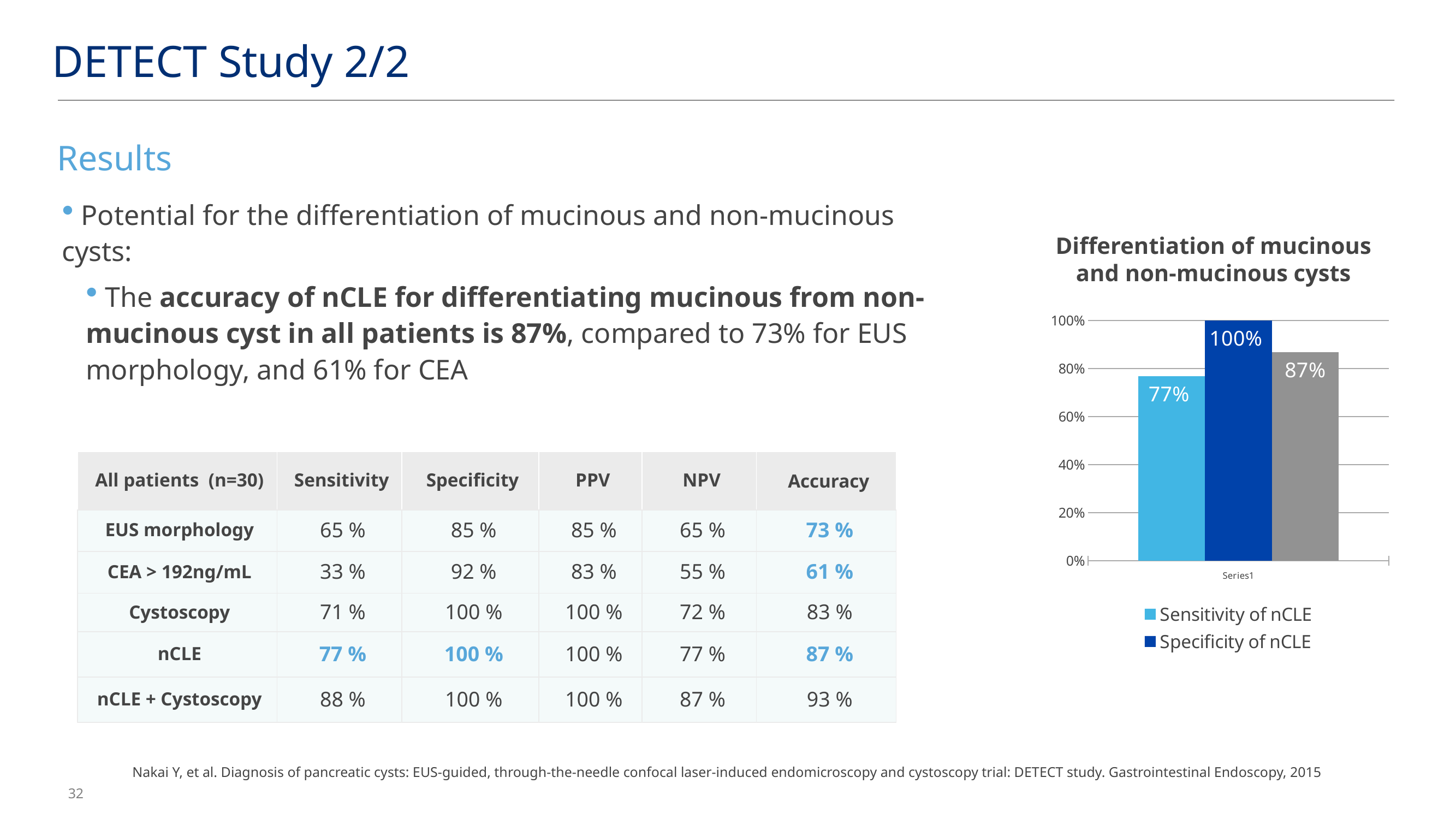
Which legend series has the highest bar in the chart? Specificity of nCLE Is the value for Sensitivity of nCLE greater or less than 80%? less What is the difference between the Specificity of nCLE bar and the Sensitivity of nCLE bar? 23 percentage points What is the title of the chart on the slide? Differentiation of mucinous and non-mucinous cysts What is the value shown for Sensitivity of nCLE in the chart? 77% How many series does the chart's legend list? 2 What is the value shown for Specificity of nCLE in the chart? 100% How many bars are plotted in the chart? 3 Which bar in the chart is the lowest? Sensitivity of nCLE (77%) What type of chart is shown on the slide? Bar chart What value is printed on the gray bar in the chart? 87% Which is larger in the chart, Sensitivity of nCLE or Specificity of nCLE? Specificity of nCLE